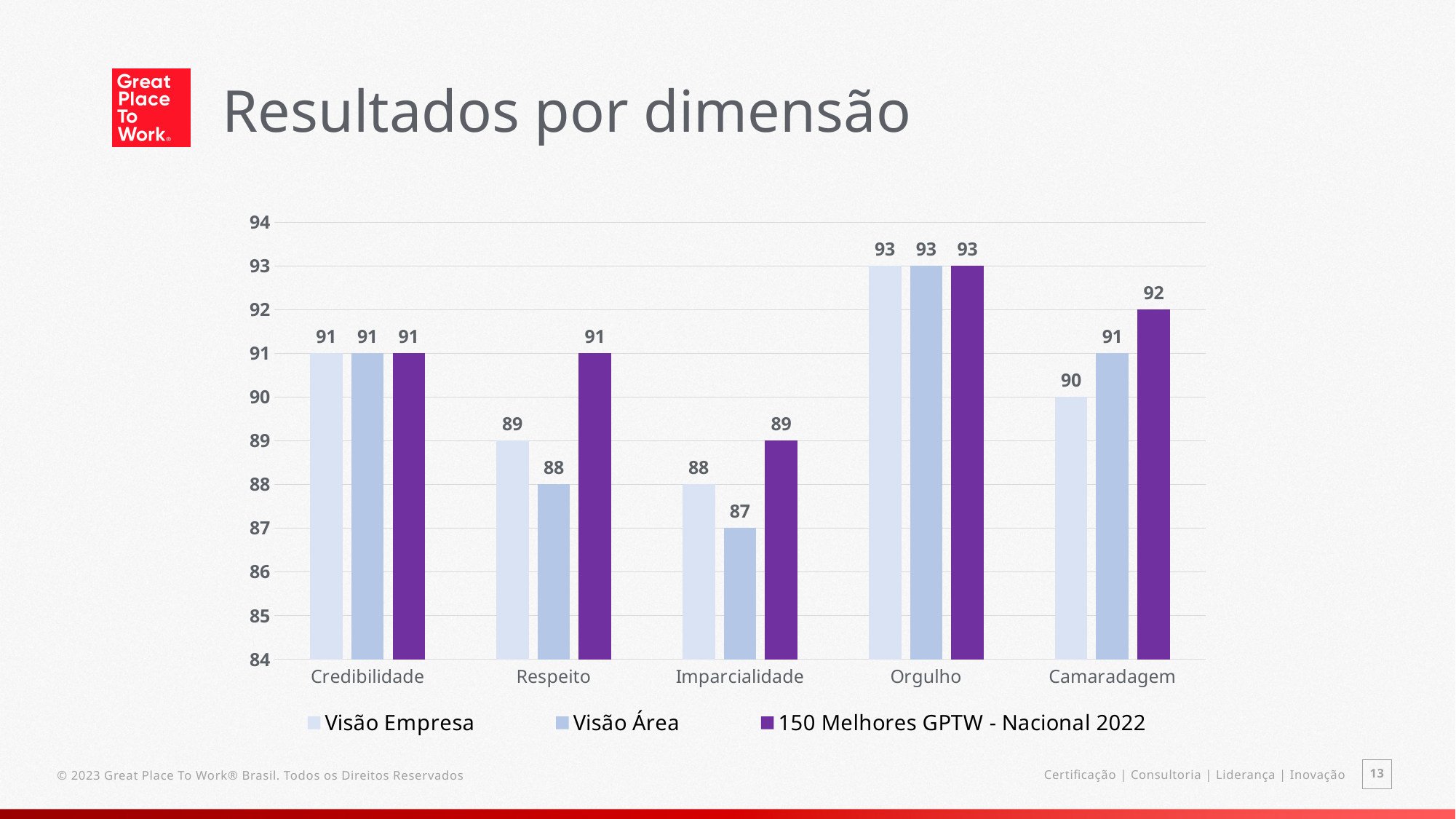
What is the value for Visão Área in the Imparcialidade category? 87 What kind of chart is shown on the slide? Bar chart What is the value for Visão Empresa in the Respeito category? 89 Which category has the highest value for Visão Empresa? Orgulho Which is larger in the Camaradagem category: Visão Empresa or Visão Área? Visão Área Which category has the lowest value for Visão Área? Imparcialidade Which series is shown in dark purple in the legend? 150 Melhores GPTW - Nacional 2022 How many series does the legend list? 3 What is the difference between the 150 Melhores GPTW - Nacional 2022 value and the Visão Área value in the Respeito category? 3 What is the title of the slide? Resultados por dimensão What is the value for 150 Melhores GPTW - Nacional 2022 in the Camaradagem category? 92 How many categories are shown on the x axis? 5